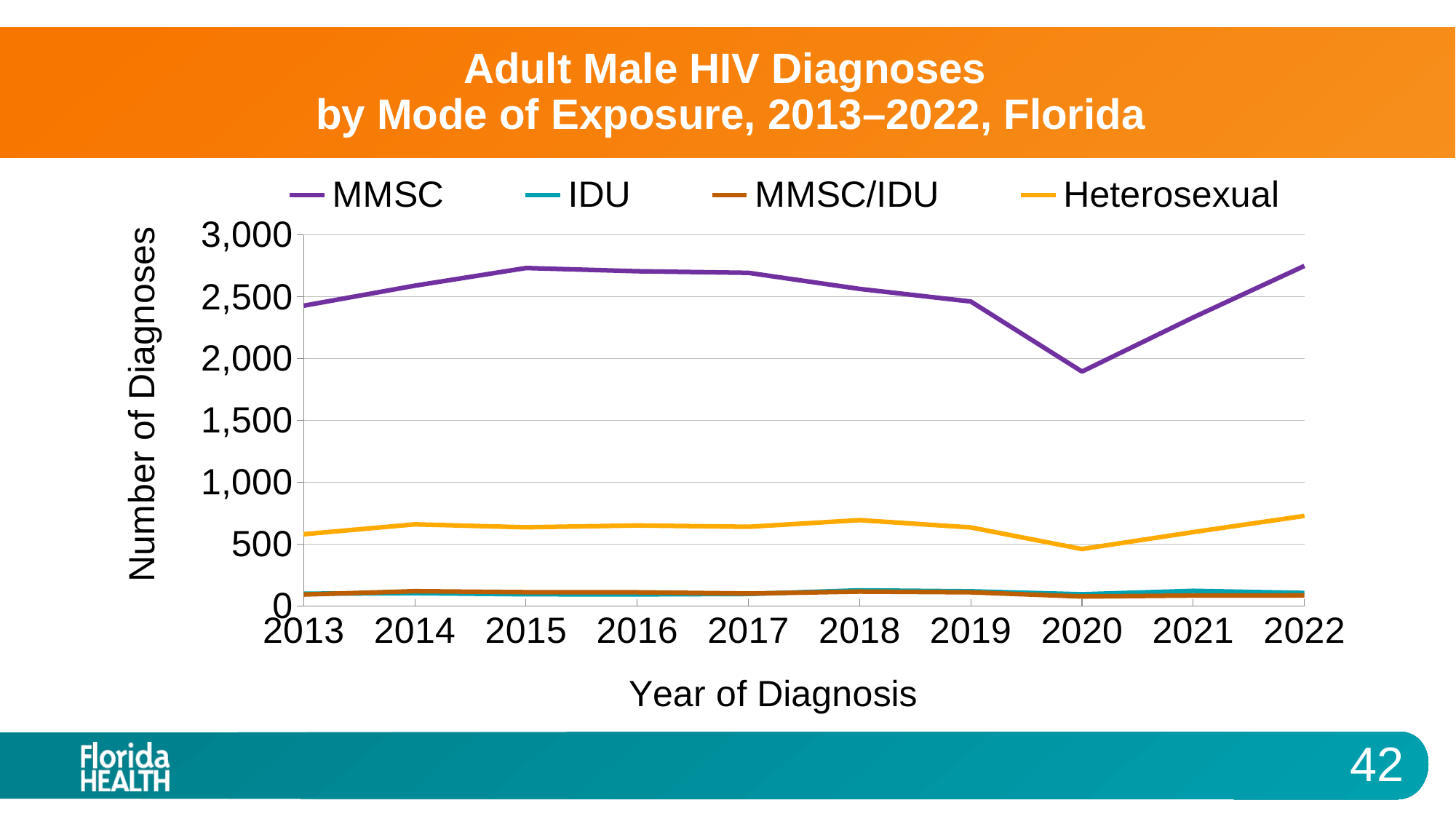
Does the MMSC line rise or fall from 2020 to 2022? rise Is the MMSC value for 2020 greater or less than 2,000? less How many years are plotted along the x axis? 10 What kind of chart is shown on the slide? line chart How many series does the legend list? 4 What is the label of the y axis? Number of Diagnoses Is the MMSC value for 2015 greater or less than 2,500? greater Is the Heterosexual value for 2022 greater or less than 500? greater In which year is the MMSC line at its lowest? 2020 In which year is the Heterosexual line at its lowest? 2020 Which series has the larger value in 2022, MMSC or Heterosexual? MMSC